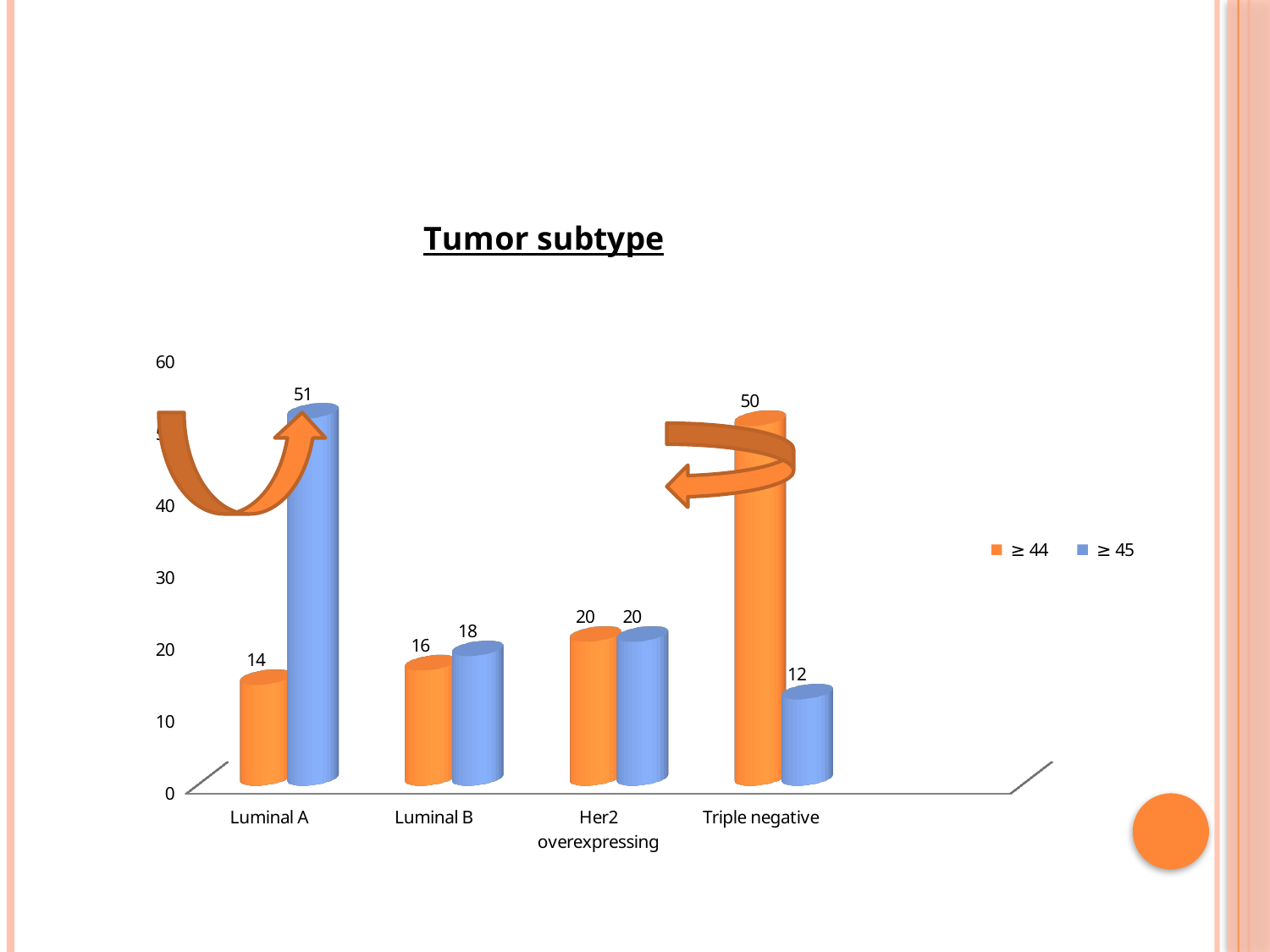
What is the value for Triple negative in the ≥ 45 series? 12 What is the title of the chart? Tumor subtype Which is larger for Luminal B: the ≥ 44 value or the ≥ 45 value? ≥ 45 What kind of chart is shown on the slide? Bar chart Which tumor subtype has the lowest value in the ≥ 45 series? Triple negative What is the value for Triple negative in the ≥ 44 series? 50 How many series does the legend list? 2 What is the value for Luminal A in the ≥ 45 series? 51 What is the value for Luminal B in the ≥ 44 series? 16 Which tumor subtype has the highest value in the ≥ 44 series? Triple negative How many tumor subtype categories are shown on the x axis? 4 What is the difference between the ≥ 45 and ≥ 44 values for Luminal A? 37